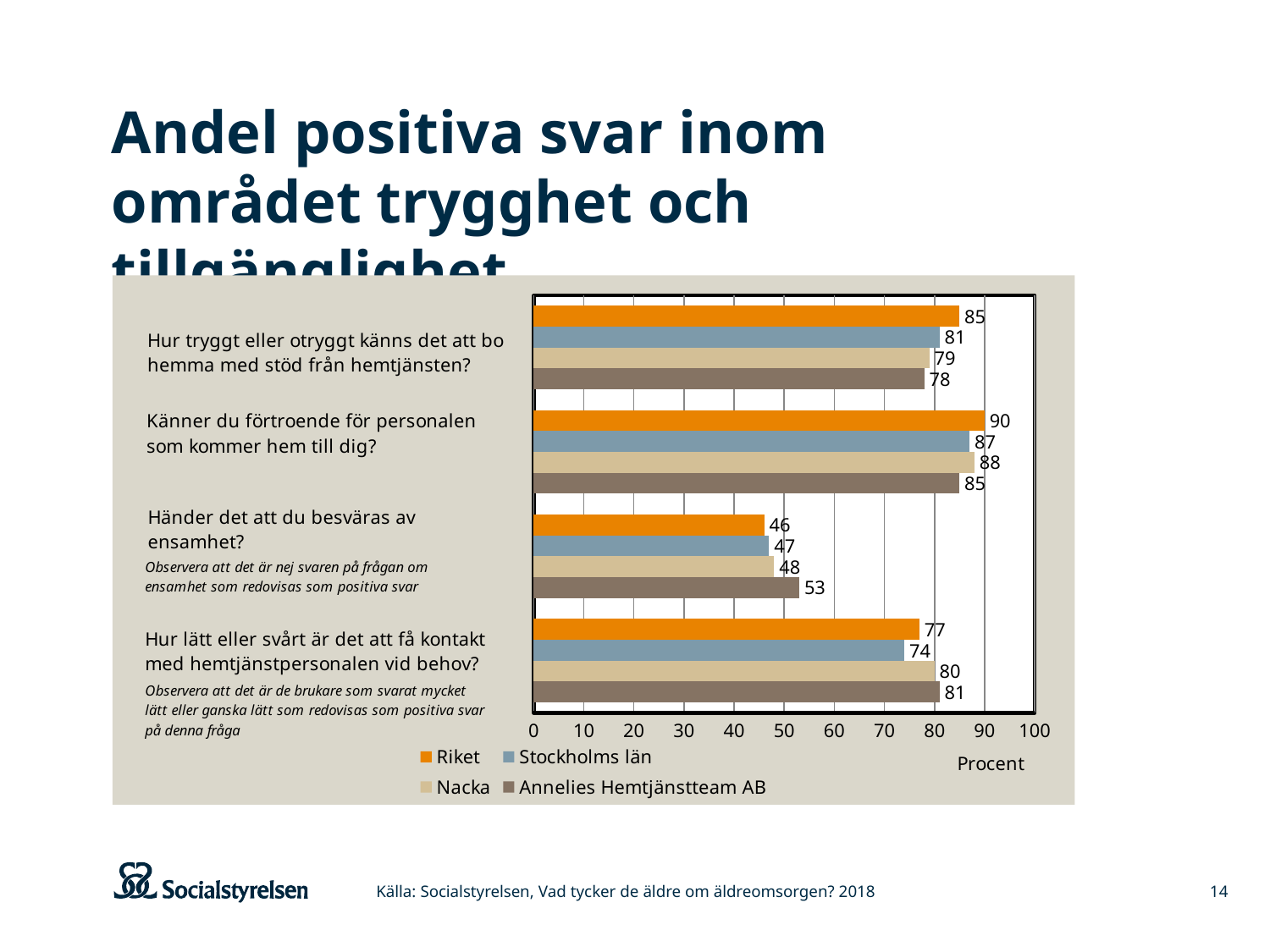
What is the value for Stockholms län on the question "Hur tryggt eller otryggt känns det att bo hemma med stöd från hemtjänsten?"? 81 What is the value for Annelies Hemtjänstteam AB on the question "Händer det att du besväras av ensamhet?"? 53 What is the label on the horizontal axis of the chart? Procent How many question categories are shown on the chart? 4 What kind of chart is shown on the slide? Bar chart Which is larger on the question "Känner du förtroende för personalen som kommer hem till dig?": Nacka or Annelies Hemtjänstteam AB? Nacka Which series has the lowest value on the question "Hur lätt eller svårt är det att få kontakt med hemtjänstpersonalen vid behov?"? Stockholms län What is the difference between Riket and Annelies Hemtjänstteam AB on the question "Hur tryggt eller otryggt känns det att bo hemma med stöd från hemtjänsten?"? 7 How many series does the legend list? 4 What is the value for Nacka on the question "Hur lätt eller svårt är det att få kontakt med hemtjänstpersonalen vid behov?"? 80 What is the value for Riket on the question "Känner du förtroende för personalen som kommer hem till dig?"? 90 Which series has the highest value on the question "Händer det att du besväras av ensamhet?"? Annelies Hemtjänstteam AB